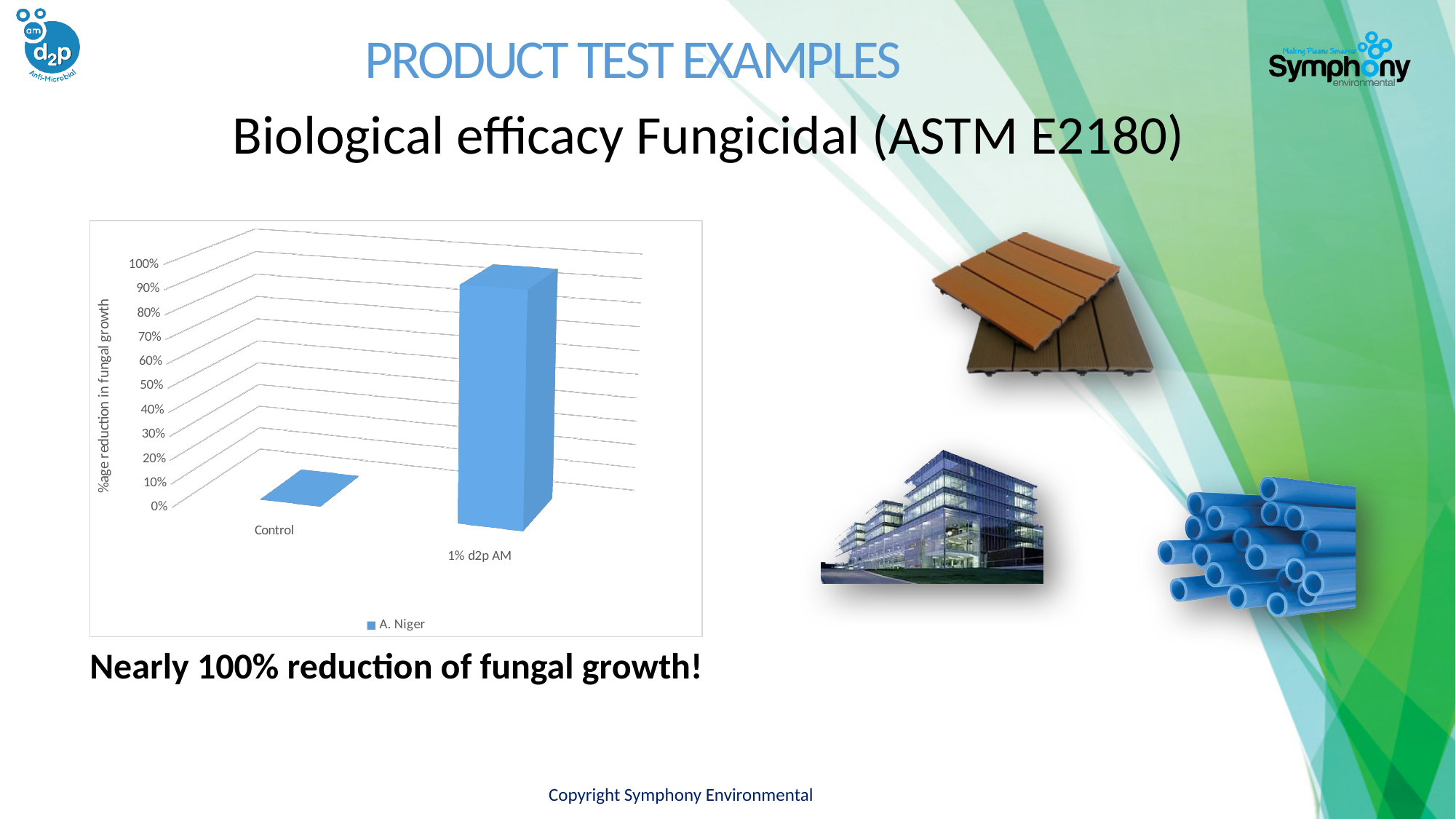
Which category has the lowest value in the chart? Control Is the value for Control greater or less than 10%? less What is the label of the vertical axis of the chart? %age reduction in fungal growth How many categories are shown on the x axis of the chart? 2 Is the value for 1% d2p AM greater or less than 80%? greater Is the value for 1% d2p AM greater or less than 50%? greater What series name is shown in the chart legend? A. Niger Do the values rise or fall from Control to 1% d2p AM along the x axis? rise Which has the larger value, Control or 1% d2p AM? 1% d2p AM What kind of chart is shown on the slide? bar chart Which category has the highest value in the chart? 1% d2p AM How many series does the chart legend list? 1